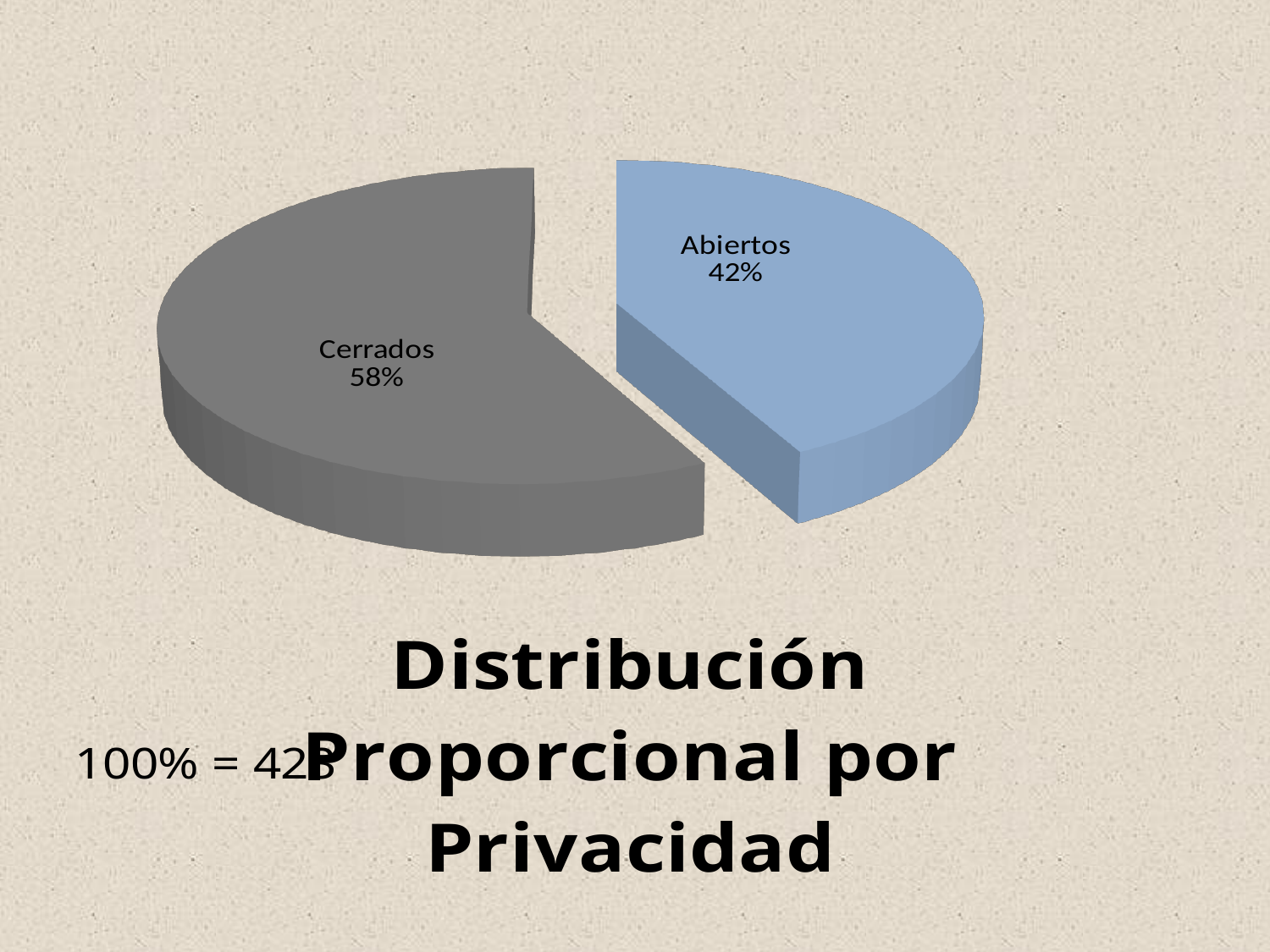
What percentage of the pie is labelled Cerrados? 58% Which is larger, the Cerrados slice or the Abiertos slice? Cerrados Which slice of the pie is the largest? Cerrados How many slices does the pie chart have? 2 What colour is the Abiertos slice? blue What percentage of the pie is labelled Abiertos? 42% What type of chart is shown on the slide? pie chart Which slice of the pie is the smallest? Abiertos What share of the pie does the Abiertos slice represent? 42% What is the title of the chart? Distribución Proporcional por Privacidad What is the difference in percentage points between the Cerrados and Abiertos slices? 16%